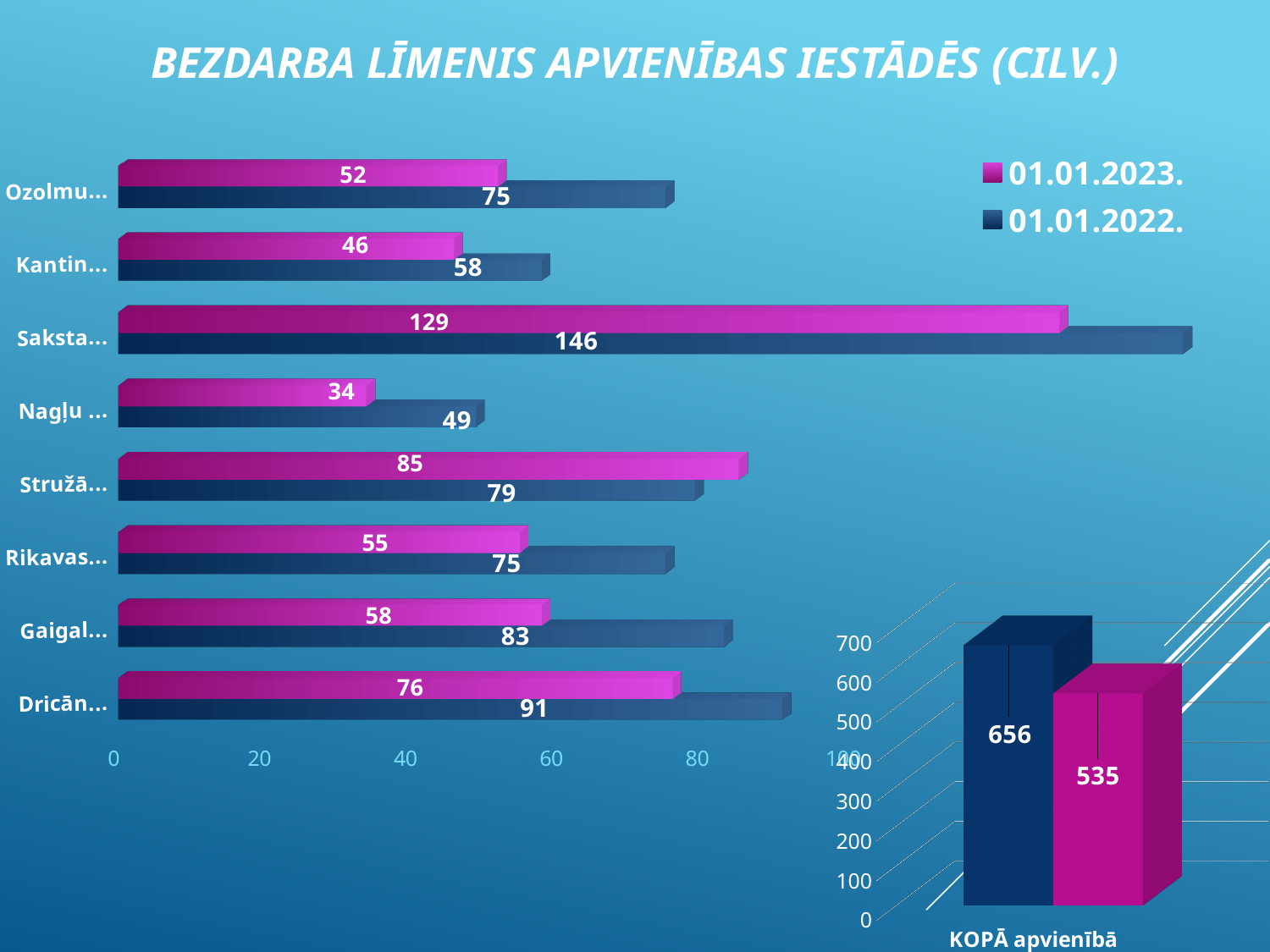
What kind of chart is the main chart on the slide? Bar chart In the KOPĀ apvienībā chart, what is the difference between the two bars? 121 In the main bar chart, which category has the highest value for 01.01.2023.? Saksta... In the main bar chart, what is the difference between the 01.01.2022. and 01.01.2023. values for Gaigal...? 25 In the main bar chart, what is the value for Saksta... for 01.01.2022.? 146 How many categories are shown in the main bar chart? 8 In the KOPĀ apvienībā chart, what is the value of the dark blue bar? 656 In the main bar chart, which is larger for Stružā...: the 01.01.2023. value or the 01.01.2022. value? 01.01.2023. In the main bar chart, which category has the lowest value for 01.01.2022.? Nagļu ... In the main bar chart, which colour represents 01.01.2023.? Magenta In the main bar chart, what is the value for Nagļu ... for 01.01.2023.? 34 How many series does the legend of the main bar chart list? 2